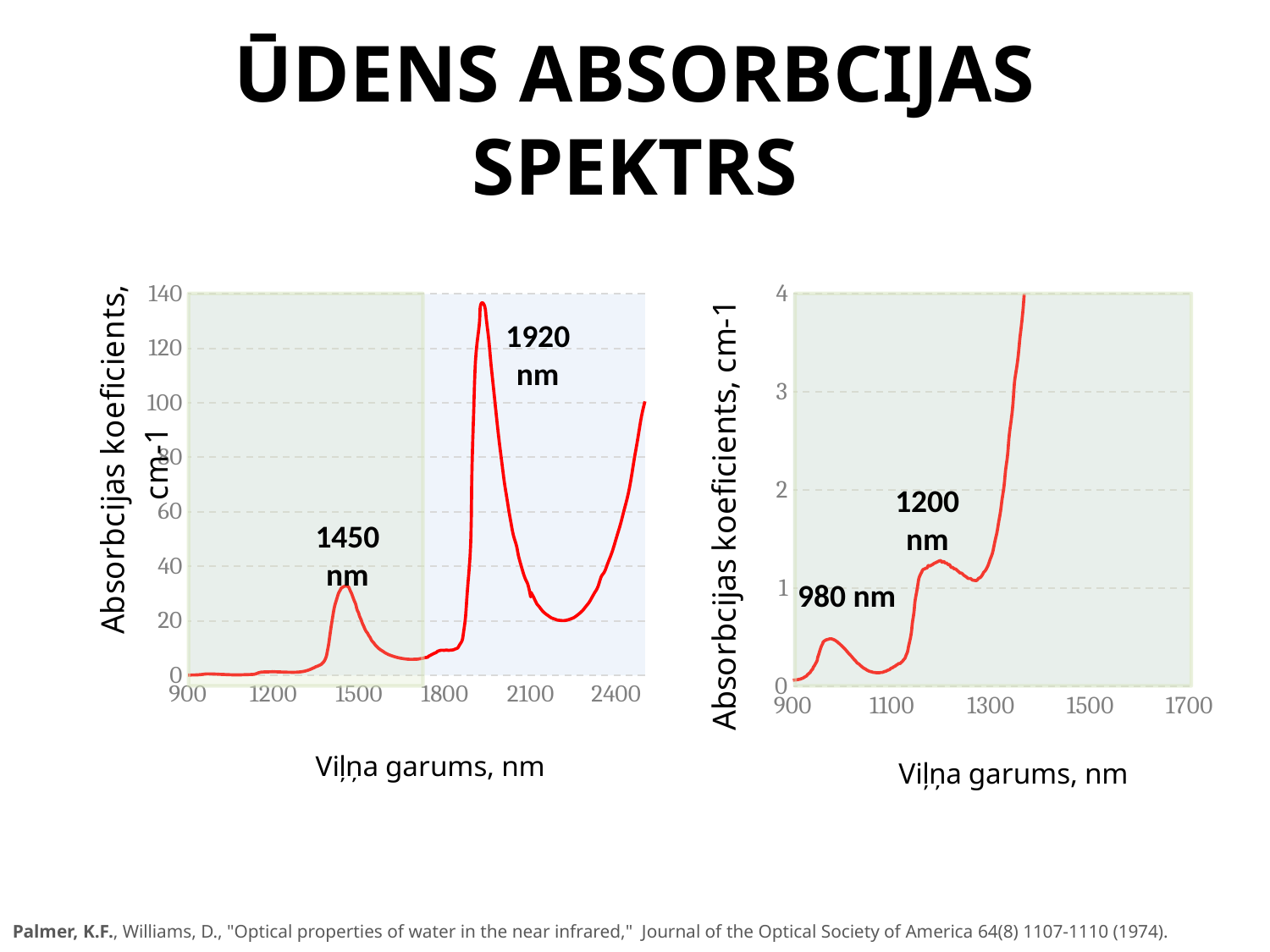
In the left chart, is the absorption coefficient at the peak labelled 1450 nm greater or less than 60? less What is the highest value shown on the y-axis of the left chart? 140 In the left chart, does the absorption coefficient rise or fall between 1920 nm and 2200 nm? fall In the right chart, which labelled peak has the higher absorption coefficient, 980 nm or 1200 nm? 1200 nm What is the x-axis title of the right chart? Viļņa garums, nm In the left chart, is the absorption coefficient at the peak labelled 1920 nm greater or less than 120? greater In the right chart, does the absorption coefficient rise or fall between 1300 nm and the end of the plotted line? rise In the left chart, which labelled peak has the higher absorption coefficient, 1450 nm or 1920 nm? 1920 nm In the right chart, is the absorption coefficient at the peak labelled 1200 nm greater or less than 2? less What kind of chart is the left chart on the slide? line chart